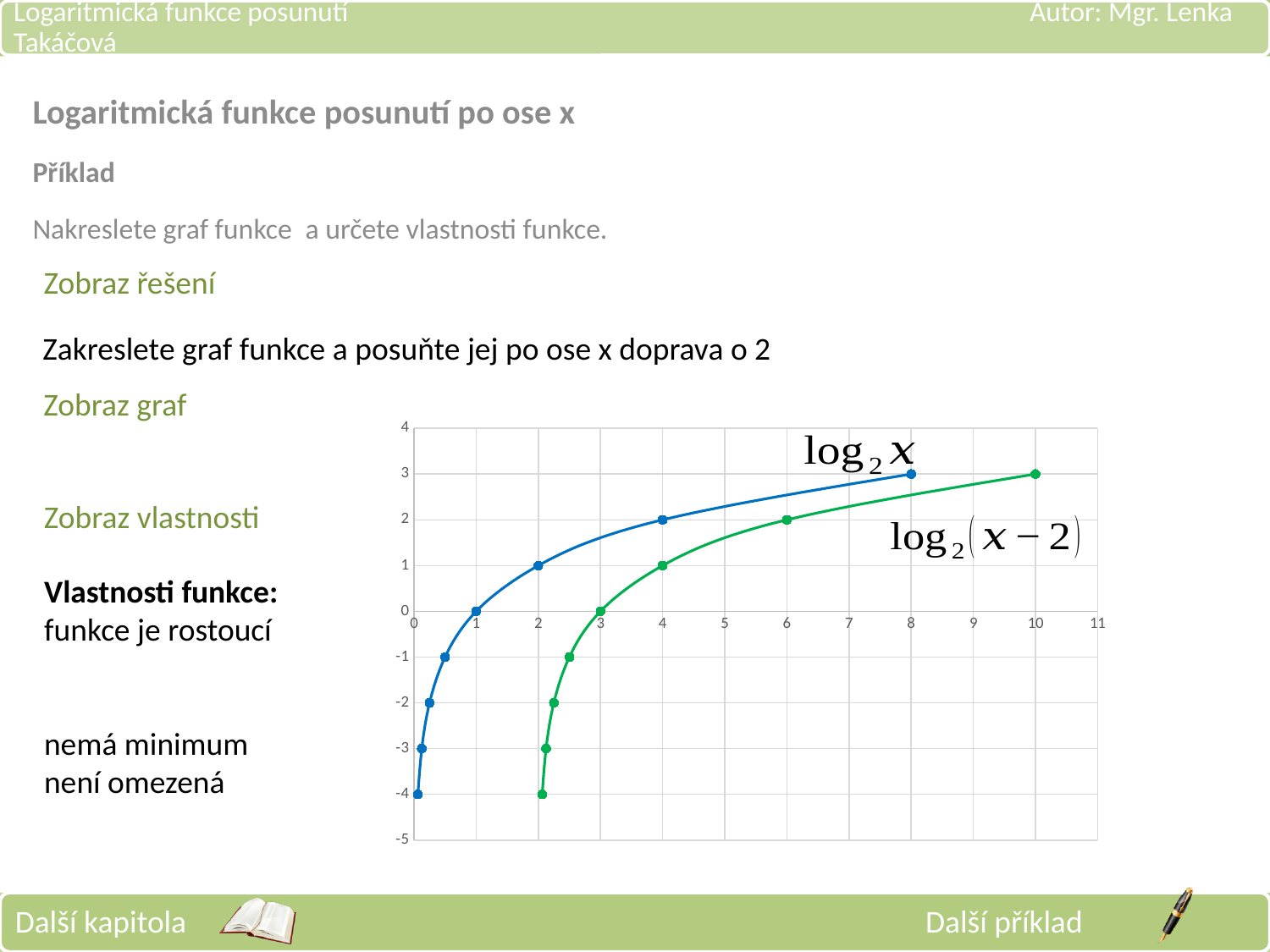
How many curves (series) are plotted on the chart? 2 At x = 4, which curve has the larger value, log₂x or log₂(x−2)? log₂x Do the values of the curves rise or fall as x increases? rise What is the lowest y value reached by the plotted points of log₂x? -4 What is the value of log₂(x−2) at x = 4? 1 What kind of chart is shown on the slide? line chart What is the value of log₂(x−2) at x = 10? 3 Which colour is used for the log₂(x−2) curve? green What is the difference between log₂x and log₂(x−2) at x = 4? 1 What is the value of log₂x at x = 8? 3 At which x value does the log₂(x−2) curve cross the x axis (y = 0)? 3 What is the value of log₂x at x = 4? 2